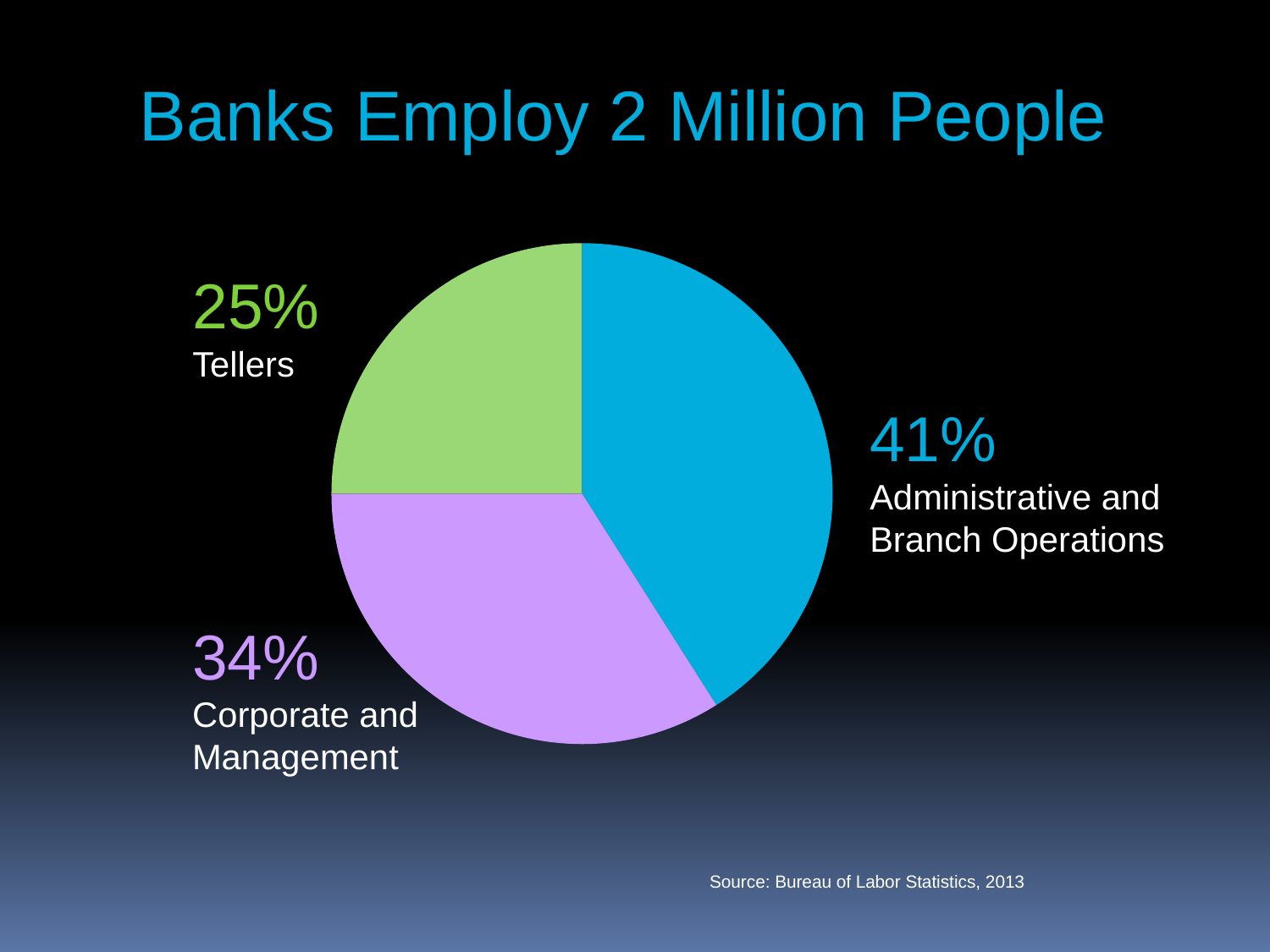
How many slices does the pie chart have? 3 What share of bank employees are in Corporate and Management? 34% What is the difference in percentage points between Administrative and Branch Operations and Tellers? 16 What is the title of the slide containing the pie chart? Banks Employ 2 Million People Which category has the largest share of the pie? Administrative and Branch Operations What share of bank employees work in Administrative and Branch Operations? 41% What share of bank employees are Tellers? 25% What colour is the slice for Tellers? green Which is larger, the share for Corporate and Management or the share for Tellers? Corporate and Management What kind of chart is shown on the slide? pie chart What is the difference in percentage points between Corporate and Management and Tellers? 9 Which category has the smallest share of the pie? Tellers